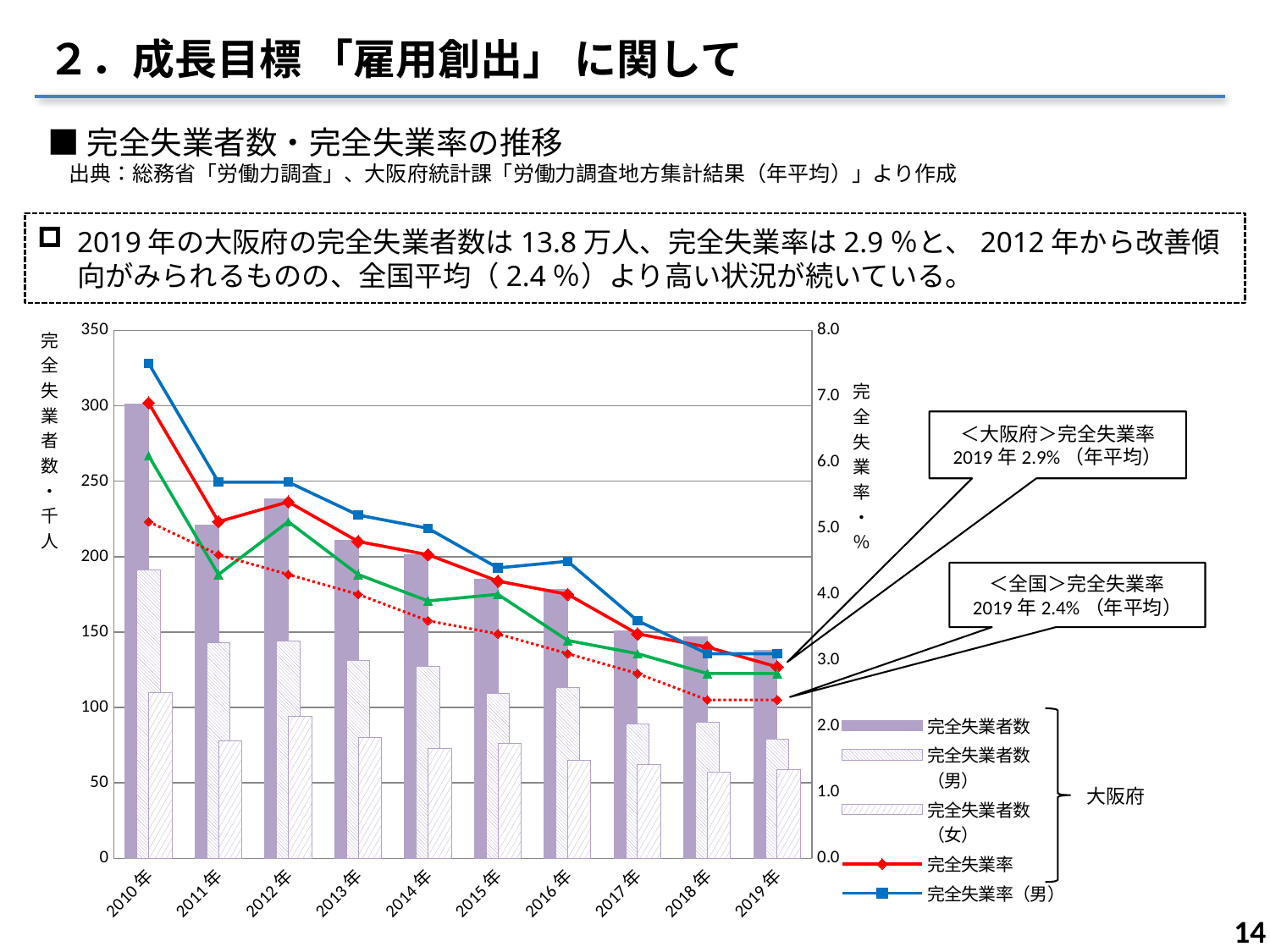
According to the callout on the chart, what was Osaka Prefecture's unemployment rate (完全失業率) in 2019? 2.9% Is the male unemployment rate (完全失業率（男）) in 2010 greater or less than 7.0%? greater By how many percentage points did Osaka's 2019 unemployment rate exceed the national 2019 rate? 0.5 percentage points Which year has the highest bar for total unemployed persons (完全失業者数)? 2010年 According to the callout on the chart, what was the national (全国) unemployment rate in 2019? 2.4% How many years are shown on the x axis of the chart? 10 How does the total number of unemployed persons change from 2010 to 2019? It falls What unit is shown on the left vertical axis label of the chart? 千人 (thousand persons) In 2019, which was higher: Osaka Prefecture's unemployment rate or the national unemployment rate? Osaka Prefecture's Is the total unemployed persons bar for 2010 greater or less than 250 thousand? greater Is the total unemployed persons bar for 2019 greater or less than 150 thousand? less What kind of chart is shown on the slide? A combined bar and line chart